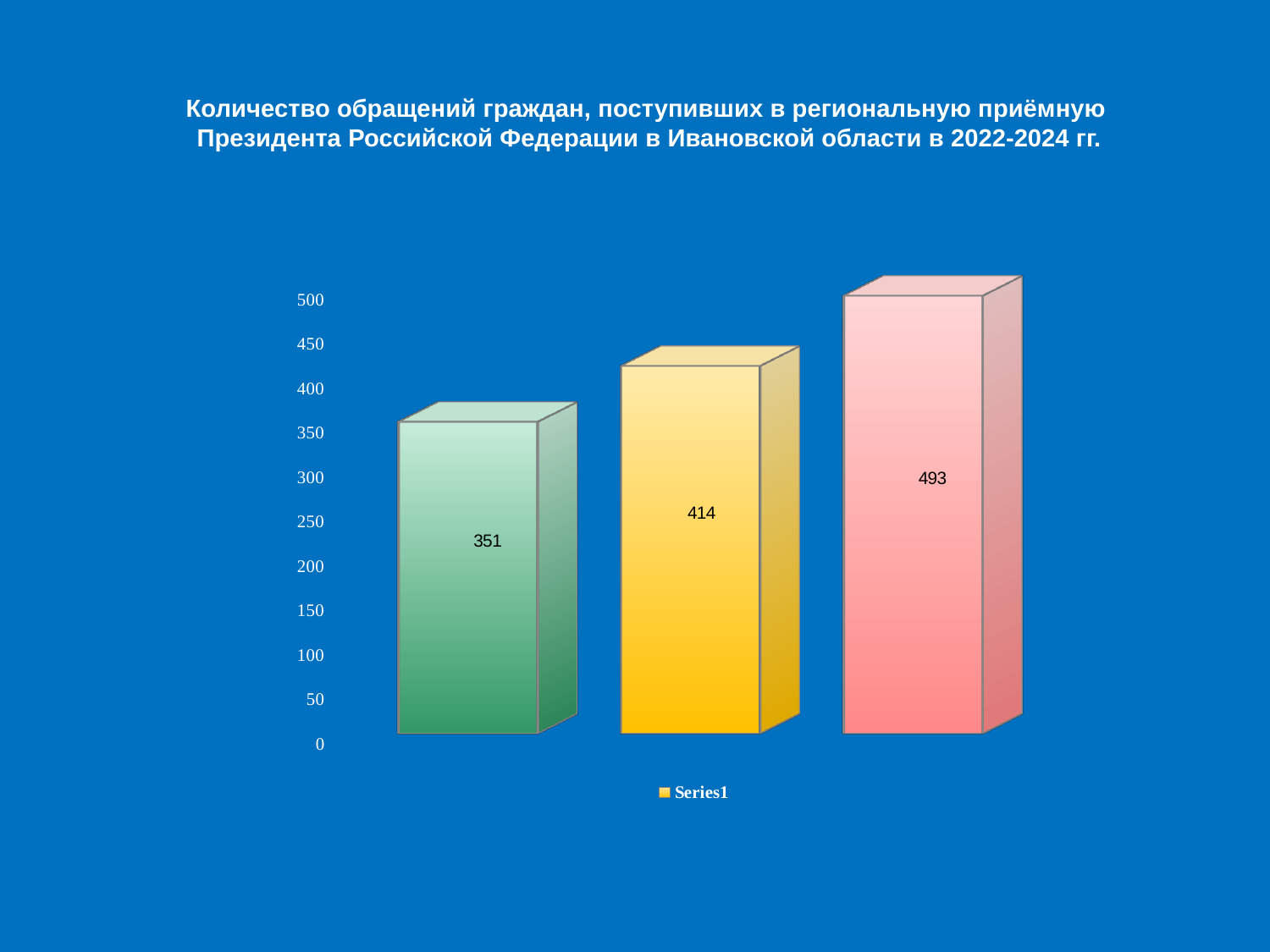
What is the value shown on the right (pink) bar? 493 Which is larger, the value of the middle bar or the value of the right bar? The right bar (493) What kind of chart is shown on the slide? Bar chart How many bars are plotted in the chart? 3 How many series does the legend list? 1 Which bar has the highest value? The right (pink) bar, 493 What is the value shown on the left (green) bar? 351 Which bar has the lowest value? The left (green) bar, 351 What is the value shown on the middle (yellow) bar? 414 What is the difference between the right bar's value and the left bar's value? 142 What is the difference between the middle bar's value and the left bar's value? 63 Do the bar values rise or fall from left to right? Rise